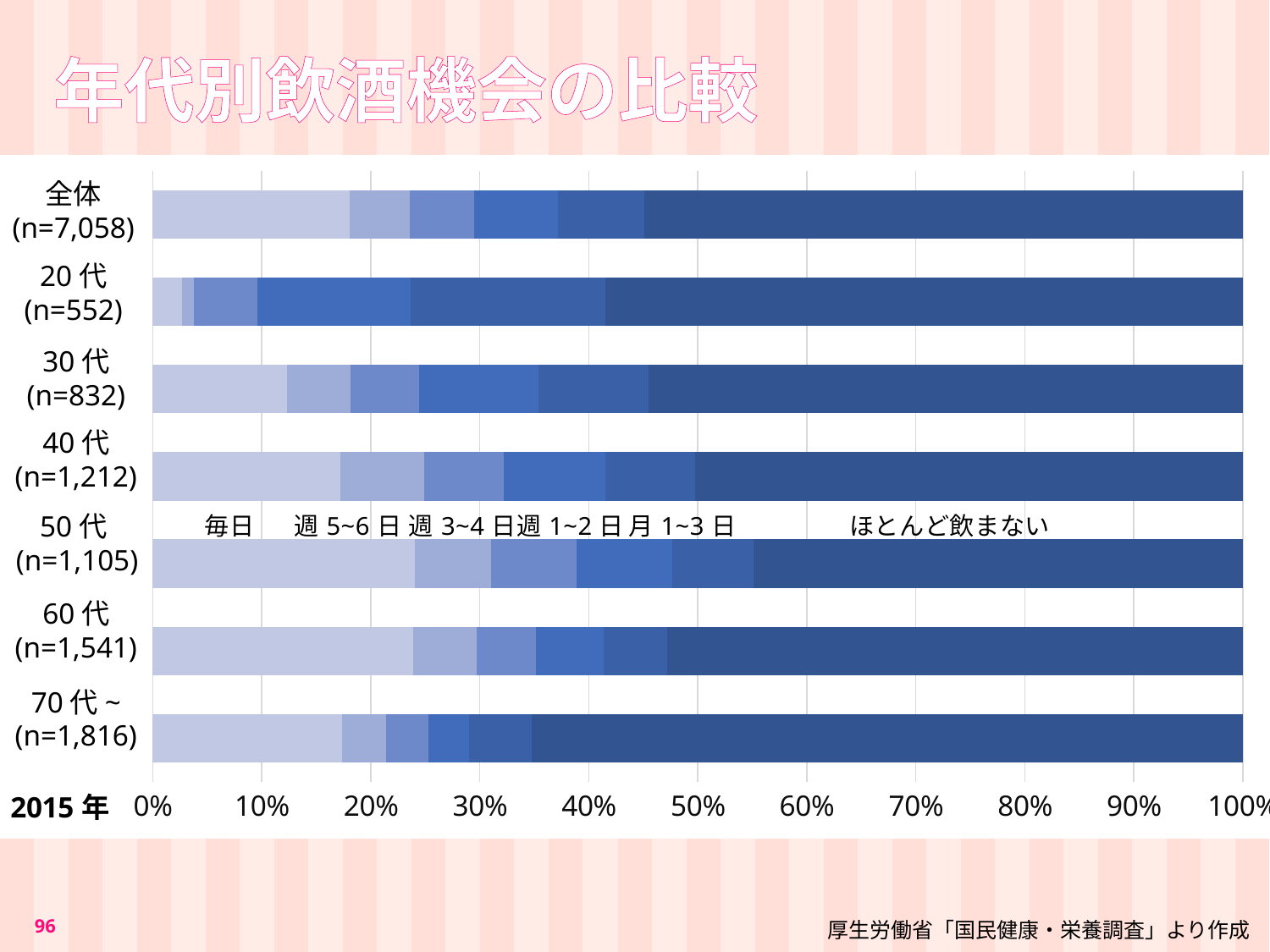
Is the ほとんど飲まない share for 70代~ (n=1,816) greater or less than 60%? greater What is the title of the chart on the slide? 年代別飲酒機会の比較 What is the first legend entry (leftmost segment) in the chart? 毎日 How many series does the chart's legend list? 6 Which age group has the largest ほとんど飲まない (almost never drink) share? 70代~ (n=1,816) What kind of chart is shown on the slide? stacked bar chart Is the 毎日 share for 50代 (n=1,105) greater or less than 20%? greater Is the 毎日 share for 20代 (n=552) greater or less than 10%? less How many age-group categories (bars) are plotted in the chart? 7 Which age group has the smallest ほとんど飲まない (almost never drink) share? 50代 (n=1,105) Which age group has the smallest 毎日 (every day) share? 20代 (n=552) Which has the larger 毎日 share, 20代 (n=552) or 50代 (n=1,105)? 50代 (n=1,105)